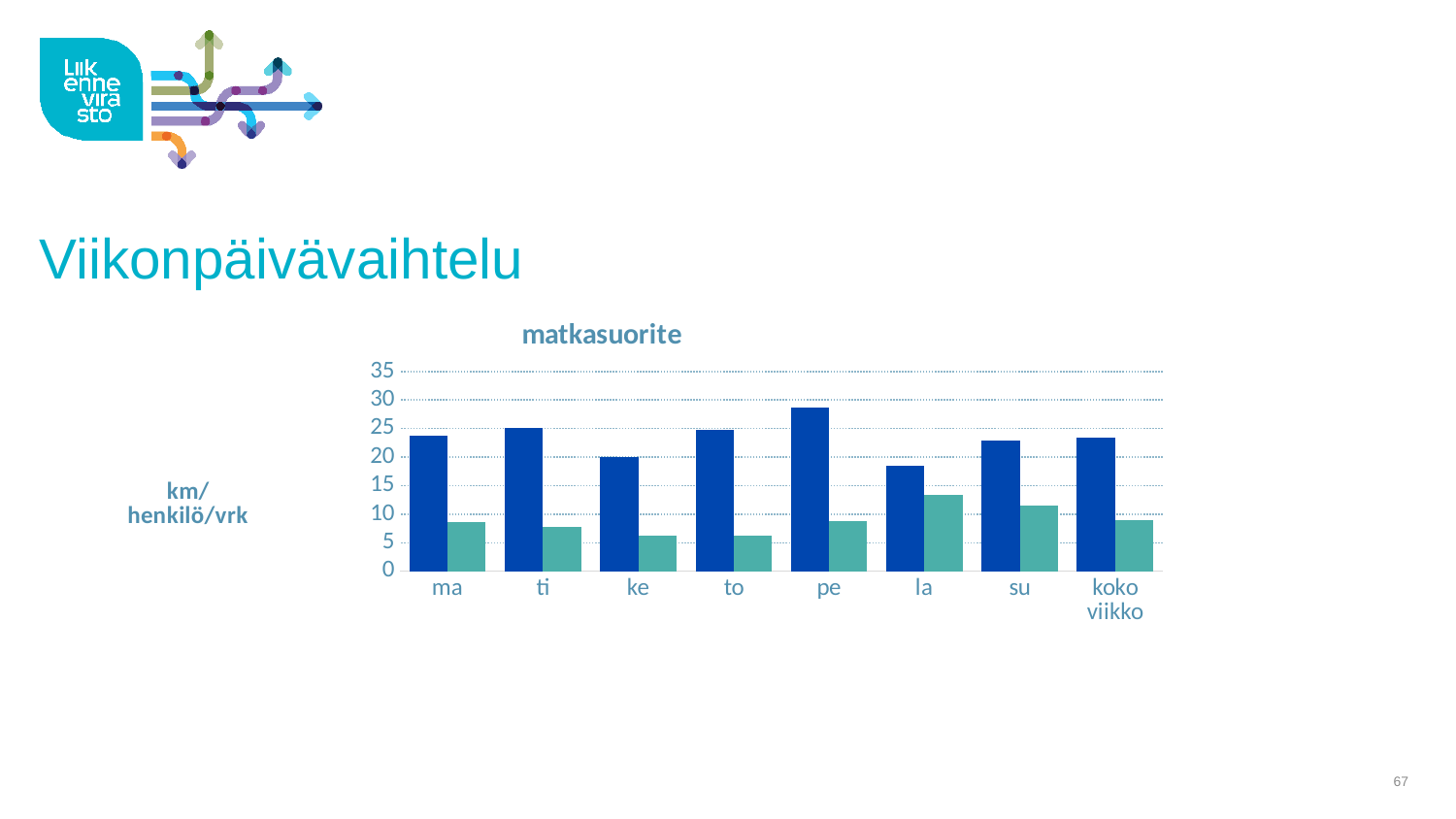
What kind of chart is shown on the slide? bar chart Is the dark blue value for la greater or less than 20? less Which category has the highest dark blue bar? pe Is the dark blue value for pe greater or less than 25? greater What is the title of the chart? matkasuorite Which category has the lowest dark blue bar? la How many categories are shown on the x axis of the chart? 8 What unit label is shown to the left of the chart? km/henkilö/vrk Is the teal value for la greater or less than 10? greater Which category has the highest teal bar? la Which is larger, the dark blue bar for ti or the dark blue bar for ke? ti